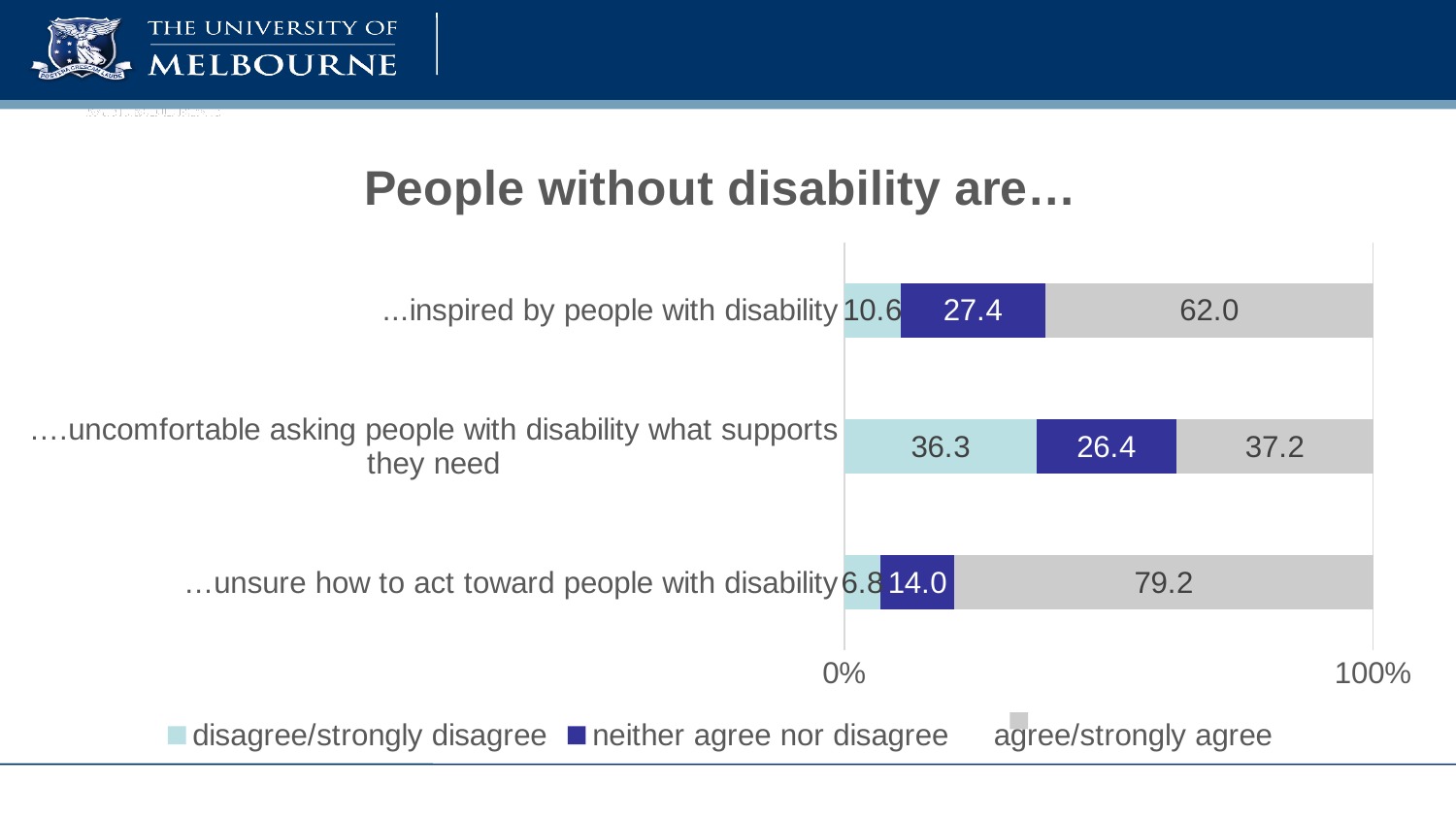
What kind of chart is shown on the slide? Stacked bar chart Which is larger: the neither agree nor disagree value for "...inspired by people with disability" or for "...uncomfortable asking people with disability what supports they need"? ...inspired by people with disability What is the value for neither agree nor disagree for "...unsure how to act toward people with disability"? 14.0 What is the title of the chart? People without disability are… What is the difference between the agree/strongly agree values for "...unsure how to act toward people with disability" and "...inspired by people with disability"? 17.2 Which category has the highest agree/strongly agree value? ...unsure how to act toward people with disability How many series does the legend list? 3 What is the value for disagree/strongly disagree for "...uncomfortable asking people with disability what supports they need"? 36.3 What is the value for agree/strongly agree for "...inspired by people with disability"? 62.0 Which category has the lowest disagree/strongly disagree value? ...unsure how to act toward people with disability What is the total of the stacked bar for "...uncomfortable asking people with disability what supports they need"? 99.9 How many categories are shown on the chart? 3